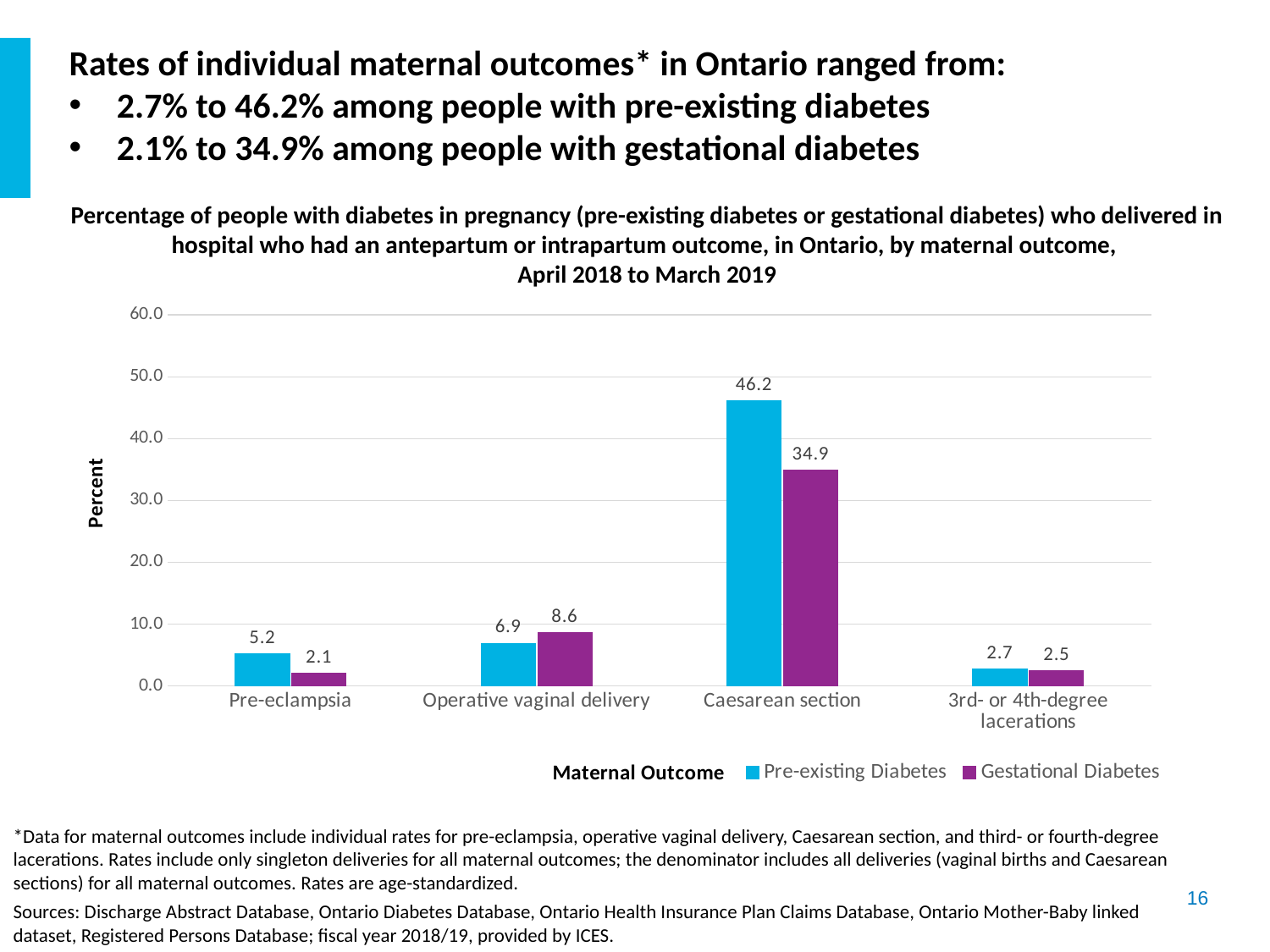
Which maternal outcome has the highest value for Pre-existing Diabetes? Caesarean section What kind of chart is shown on the slide? Bar chart What is the value for Pre-existing Diabetes for Caesarean section? 46.2 What is the value for Gestational Diabetes for Operative vaginal delivery? 8.6 What is the value for Pre-existing Diabetes for 3rd- or 4th-degree lacerations? 2.7 What is the value for Gestational Diabetes for Pre-eclampsia? 2.1 How many series does the legend list? 2 What is the difference between the Pre-existing Diabetes and Gestational Diabetes values for Caesarean section? 11.3 How many maternal outcome categories are shown on the x axis? 4 Which maternal outcome has the lowest value for Gestational Diabetes? Pre-eclampsia Is the Gestational Diabetes value for Caesarean section greater or less than 30.0? greater For Operative vaginal delivery, which series has the larger value: Pre-existing Diabetes or Gestational Diabetes? Gestational Diabetes